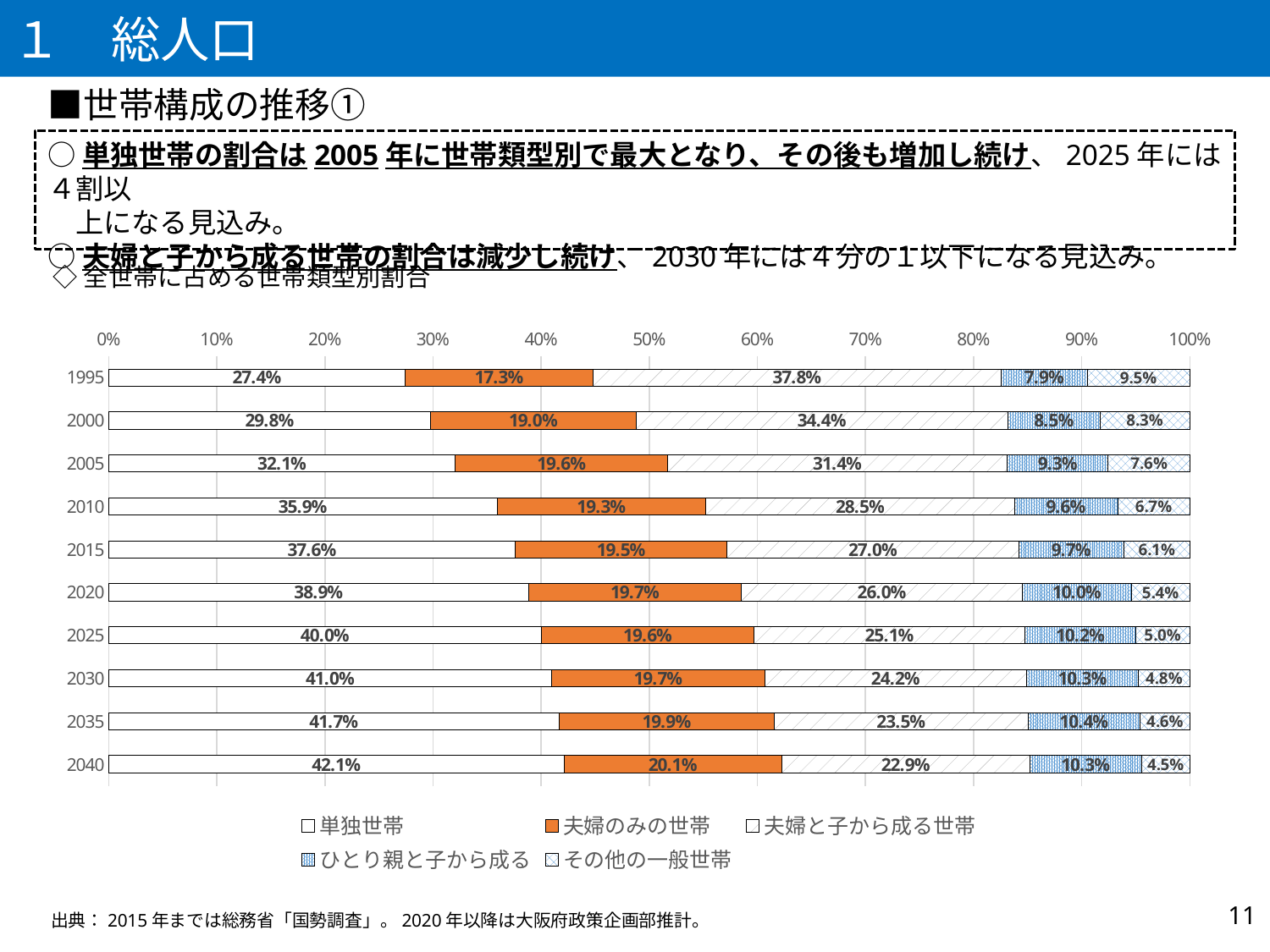
What is the value for ひとり親と子から成る in 2020? 10.0% What is the value for その他の一般世帯 in 2005? 7.6% What kind of chart is shown on the slide? Stacked bar chart Does the value for 夫婦と子から成る世帯 rise or fall from 1995 to 2040? Fall What is the value for 単独世帯 in 2040? 42.1% What is the difference between 夫婦と子から成る世帯 and 単独世帯 in 1995? 10.4% How many series does the legend list? 5 In which year is the value for 単独世帯 the highest? 2040 What is the value for 夫婦と子から成る世帯 in 1995? 37.8% In 2010, which is larger: 単独世帯 or 夫婦と子から成る世帯? 単独世帯 How many years (categories) are shown on the chart? 10 In which year is the value for その他の一般世帯 the lowest? 2040